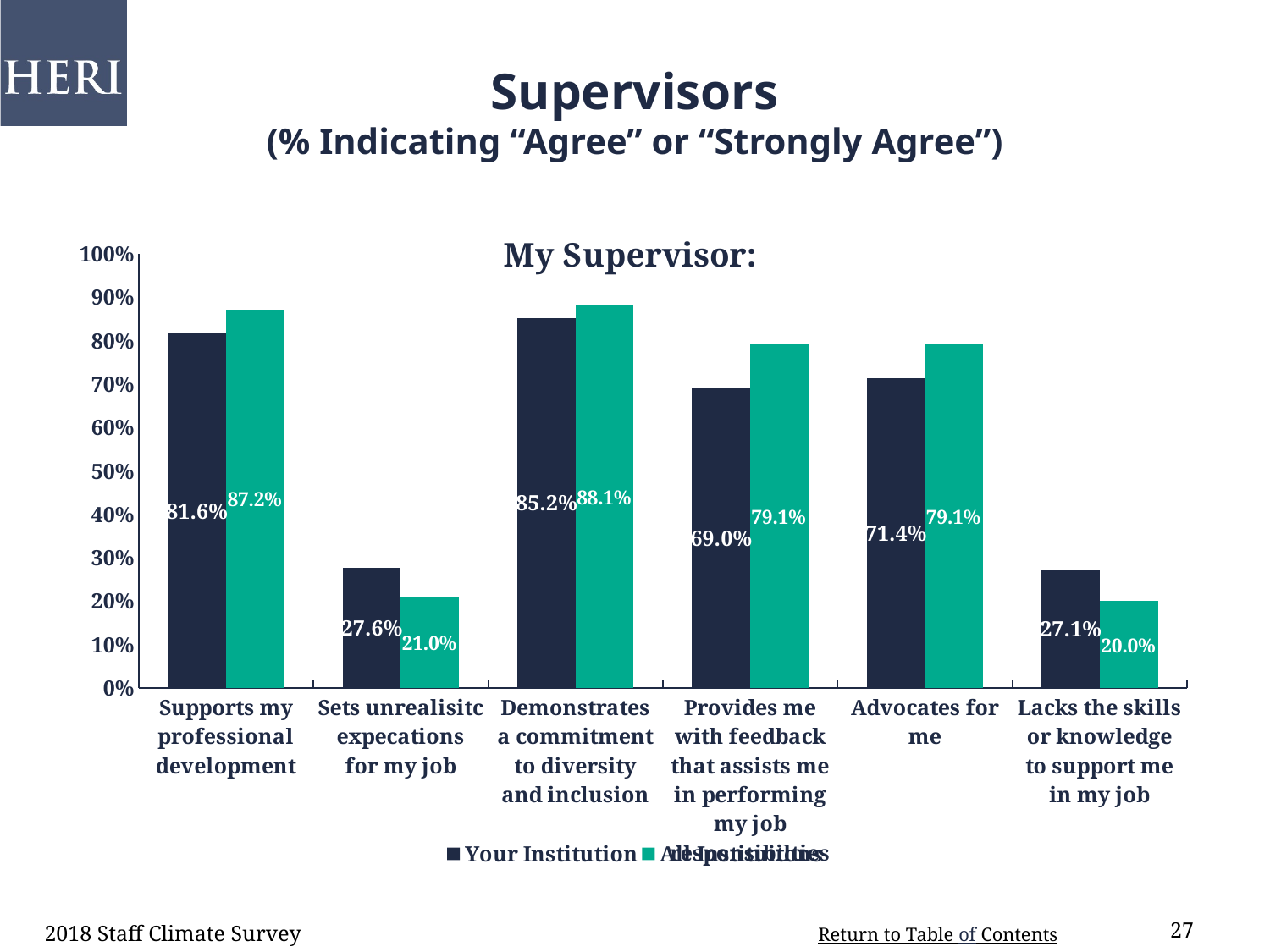
For "Sets unrealistic expectations for my job", which series has the larger value, "Your Institution" or "All Institutions"? Your Institution What is the difference between the "All Institutions" and "Your Institution" values for "Provides me with feedback that assists me in performing my job responsibilities"? 10.1% How many series does the chart's legend list? 2 What is the title shown above the chart's plot area? My Supervisor: What is the value for "Your Institution" for "Advocates for me"? 71.4% What kind of chart is shown on the slide? Bar chart Which category has the lowest value for "Your Institution"? Lacks the skills or knowledge to support me in my job Which category has the highest value for "All Institutions"? Demonstrates a commitment to diversity and inclusion Is the "Your Institution" value for "Provides me with feedback that assists me in performing my job responsibilities" greater or less than 60%? greater What is the value for "All Institutions" for "Demonstrates a commitment to diversity and inclusion"? 88.1% How many categories are shown on the x axis of the chart? 6 What is the value for "Your Institution" for "Supports my professional development"? 81.6%